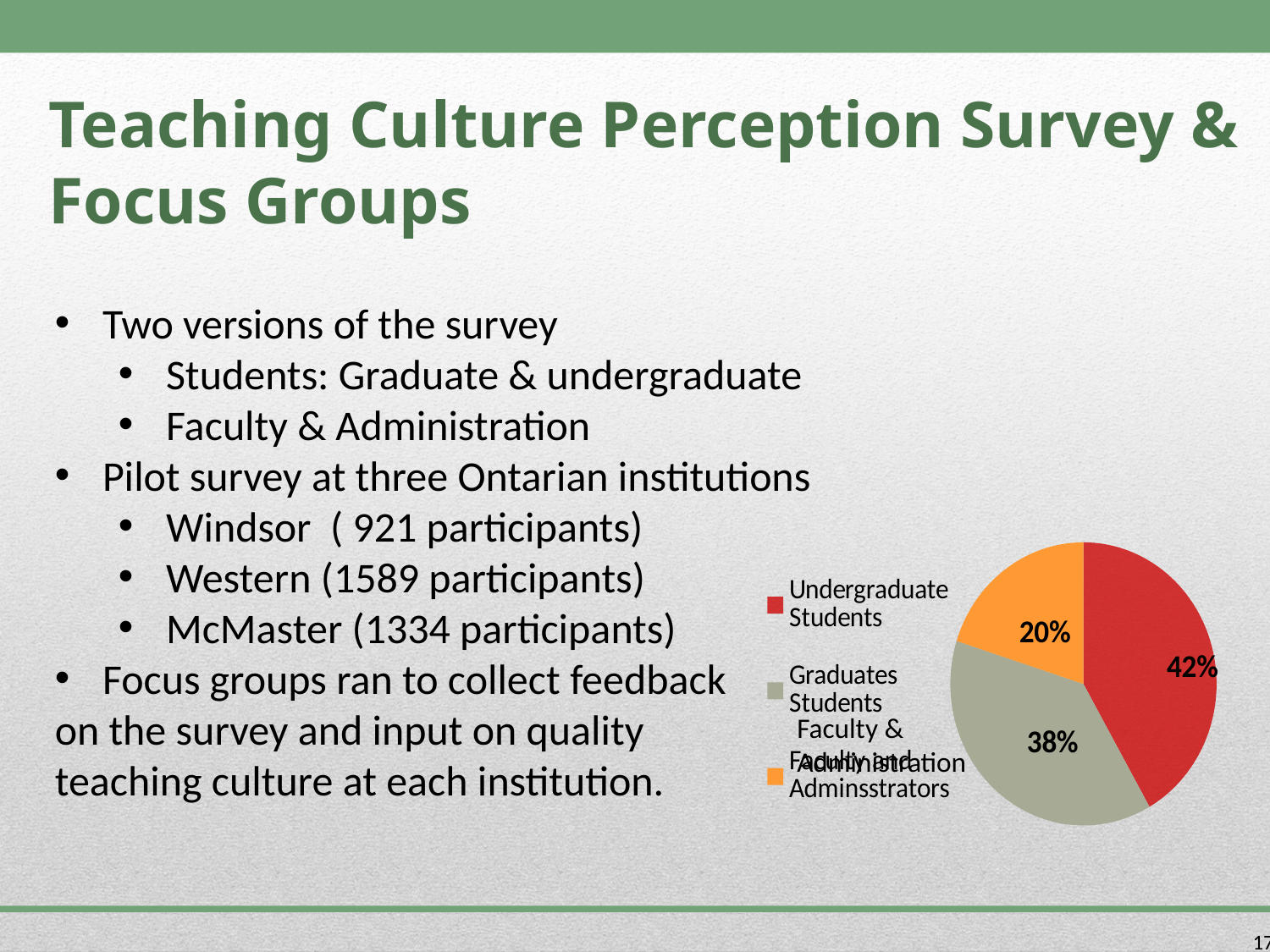
Which is larger in the pie chart, Graduates Students or the orange slice? Graduates Students What colour is the Undergraduate Students slice in the pie chart? red What kind of chart is shown on the slide? pie chart How many slices does the pie chart have? 3 What is the difference in percentage points between the Undergraduate Students slice and the Graduates Students slice? 4 What share of the pie chart is Undergraduate Students? 42% Which category has the largest slice of the pie chart? Undergraduate Students What is the difference in percentage points between the Undergraduate Students slice and the 20% slice? 22 Which slice of the pie chart is the smallest? the orange slice (20%) What share of the pie chart is the orange slice? 20% What share of the pie chart is Graduates Students? 38% Is the Graduates Students share of the pie chart greater or less than 50%? less